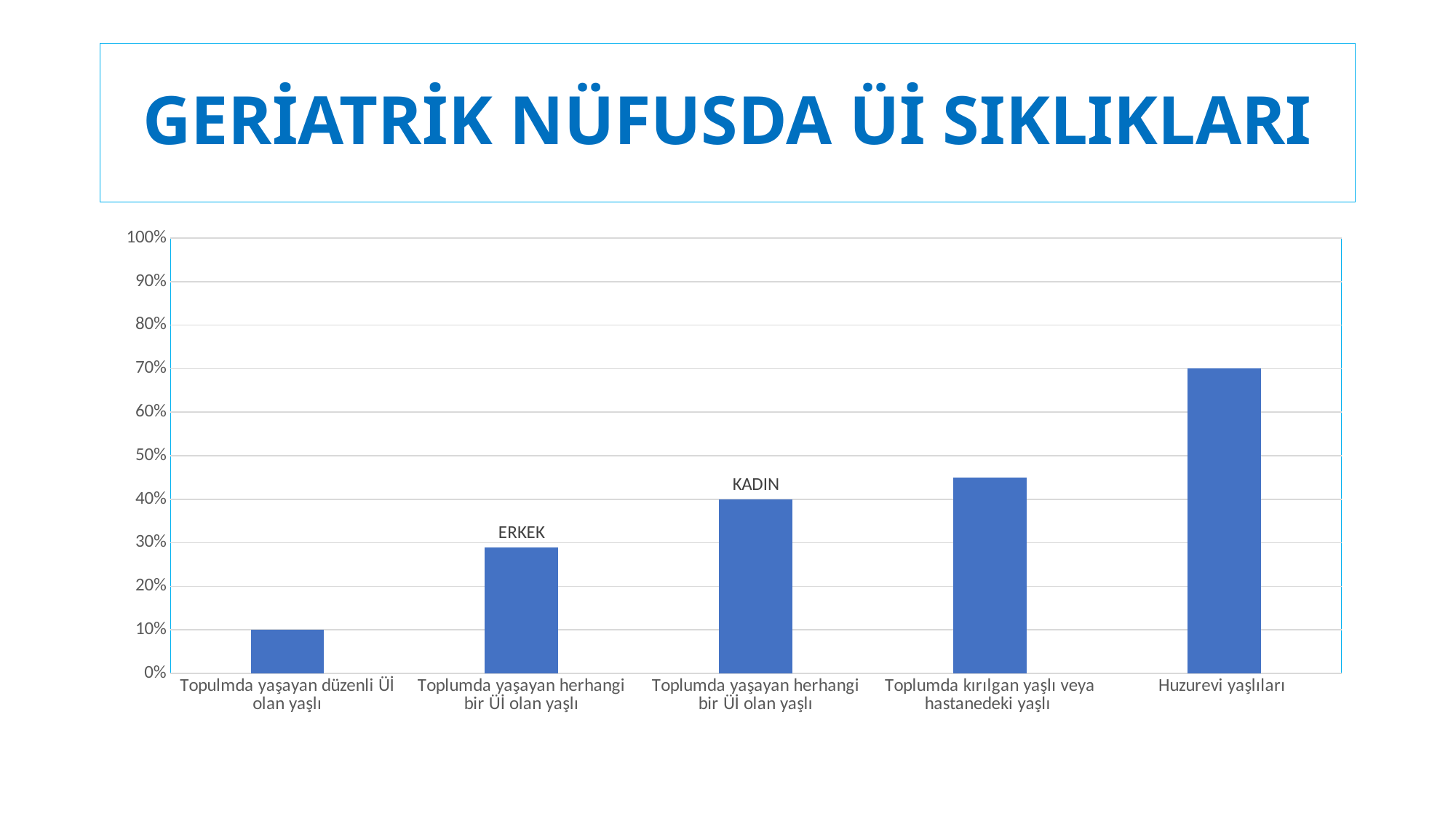
What is the difference between the value for Huzurevi yaşlıları and the value for Topulmda yaşayan düzenli Üİ olan yaşlı? 60% How many bars (categories) does the chart show? 5 What is the value for the bar labelled KADIN (Toplumda yaşayan herhangi bir Üİ olan yaşlı)? 40% Which category has the highest value? Huzurevi yaşlıları Is the value for Toplumda kırılgan yaşlı veya hastanedeki yaşlı greater or less than 40%? greater Which category has the lowest value? Topulmda yaşayan düzenli Üİ olan yaşlı What is the value for Huzurevi yaşlıları? 70% What is the value for Topulmda yaşayan düzenli Üİ olan yaşlı? 10% Which is larger: the value for the bar labelled KADIN or the bar labelled ERKEK? KADIN Is the value for the bar labelled ERKEK greater or less than 20%? greater Do the values rise or fall from left to right along the x axis? Rise What type of chart is shown on the slide? Bar chart